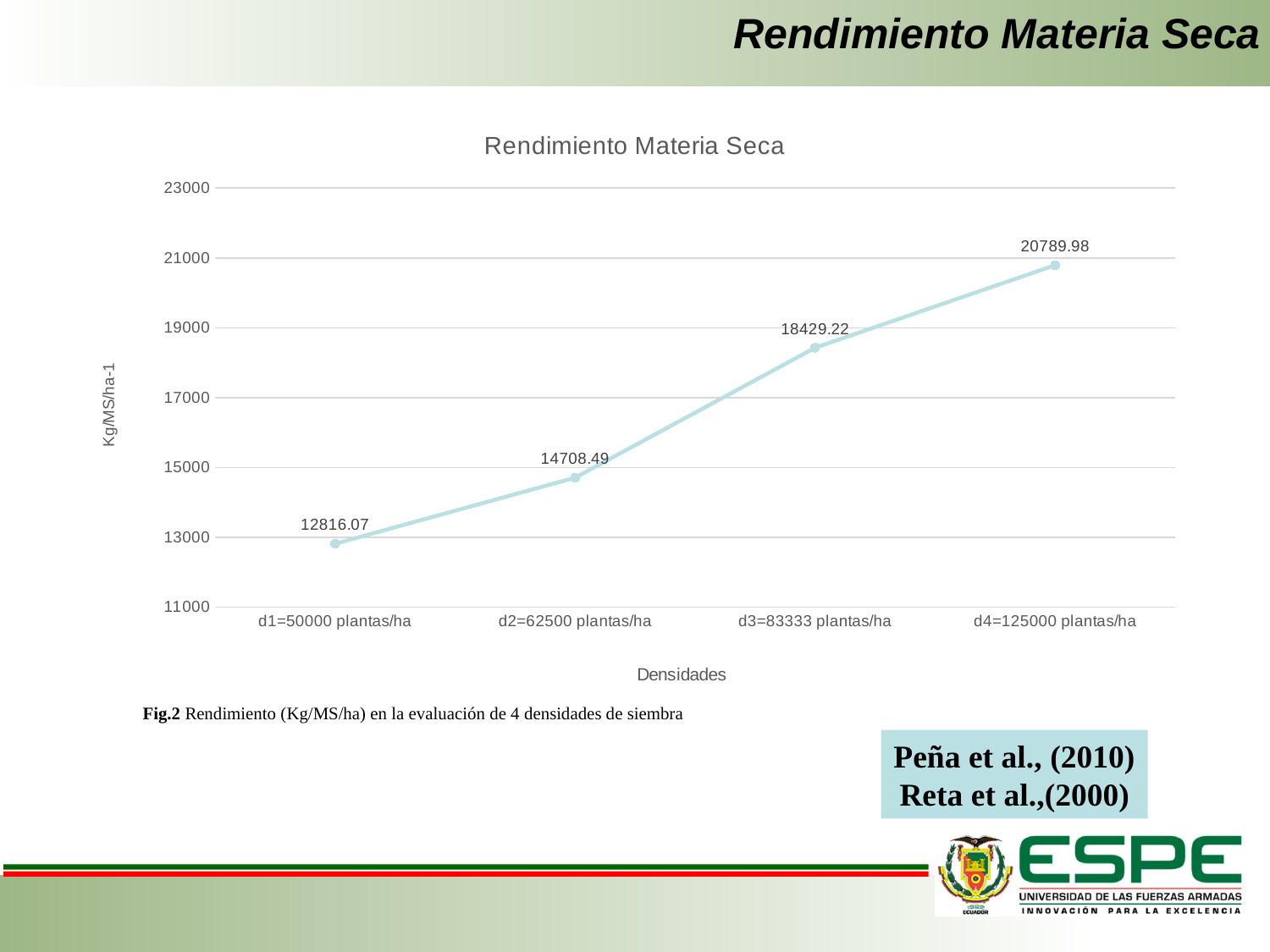
What is the value for d3=83333 plantas/ha? 18429.22 Do the values rise or fall as density increases along the x axis? rise What is the difference between the values for d4=125000 plantas/ha and d1=50000 plantas/ha? 7973.91 Which density has the highest value? d4=125000 plantas/ha Which density has the lowest value? d1=50000 plantas/ha What kind of chart is shown? line chart What is the value for d1=50000 plantas/ha? 12816.07 Which is larger, the value for d2=62500 plantas/ha or d3=83333 plantas/ha? d3=83333 plantas/ha Is the value for d2=62500 plantas/ha greater or less than 15000? less What is the difference between the values for d3=83333 plantas/ha and d2=62500 plantas/ha? 3720.73 How many densities are plotted on the chart? 4 What is the value for d4=125000 plantas/ha? 20789.98